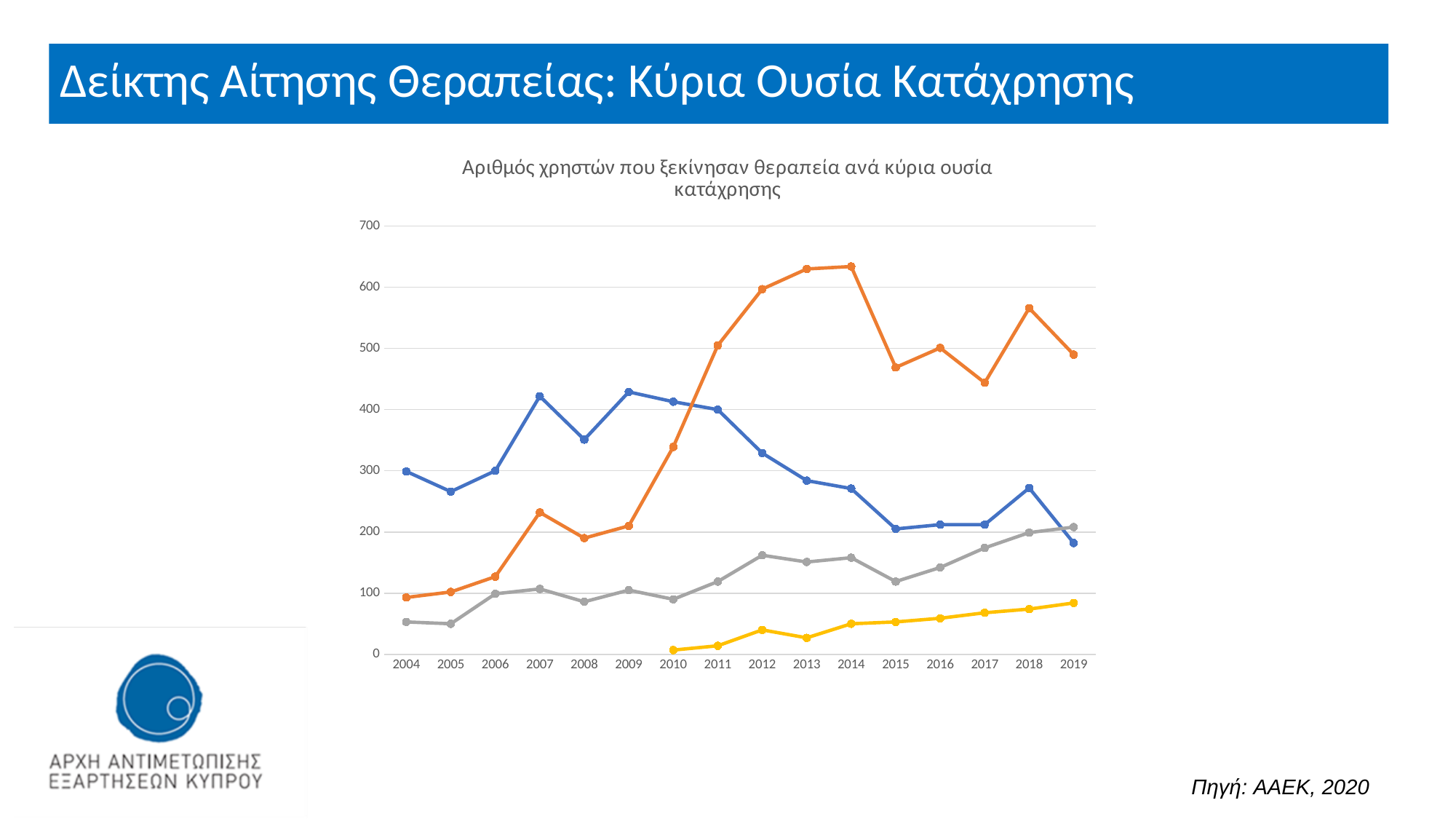
What kind of chart is shown on the slide? line chart In which year does the yellow line reach its highest value? 2019 What is the title of the chart? Αριθμός χρηστών που ξεκίνησαν θεραπεία ανά κύρια ουσία κατάχρησης Does the yellow line generally rise or fall from 2010 to 2019? rise Is the value of the grey line in 2004 greater or less than 100? less In which year does the orange line have its lowest value? 2004 How many lines are plotted on the chart? 4 Is the value of the orange line in 2014 greater or less than 600? greater How many years are shown on the x axis of the chart? 16 In 2010, which line has the higher value, the blue line or the orange line? the blue line Is the value of the blue line in 2019 greater or less than 200? less In which year does the blue line reach its lowest value? 2019